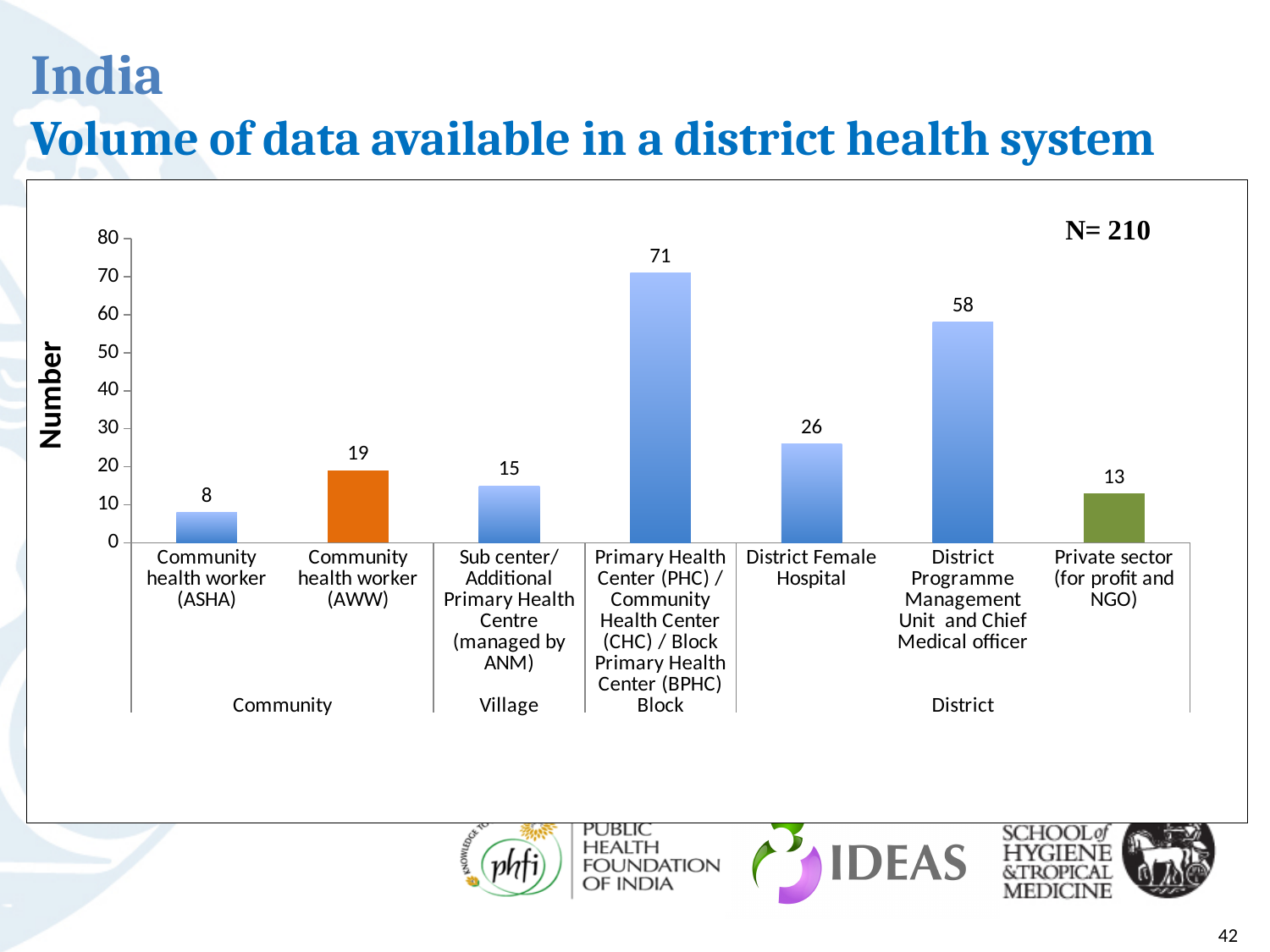
How many categories are shown on the x axis? 7 Which is larger, the value for Community health worker (AWW) or the value for Sub center/ Additional Primary Health Centre (managed by ANM)? Community health worker (AWW) What is the value for District Female Hospital? 26 What kind of chart is shown on the slide? bar chart Is the value for District Programme Management Unit and Chief Medical officer greater or less than 50? greater Which category has the lowest value? Community health worker (ASHA) Which category has the highest value? Primary Health Center (PHC) / Community Health Center (CHC) / Block Primary Health Center (BPHC) What is the N value shown on the chart? N= 210 What is the value for Community health worker (ASHA)? 8 What is the label of the y axis? Number What is the difference between the values for Primary Health Center (PHC) / Community Health Center (CHC) / Block Primary Health Center (BPHC) and District Programme Management Unit and Chief Medical officer? 13 What is the value for Private sector (for profit and NGO)? 13